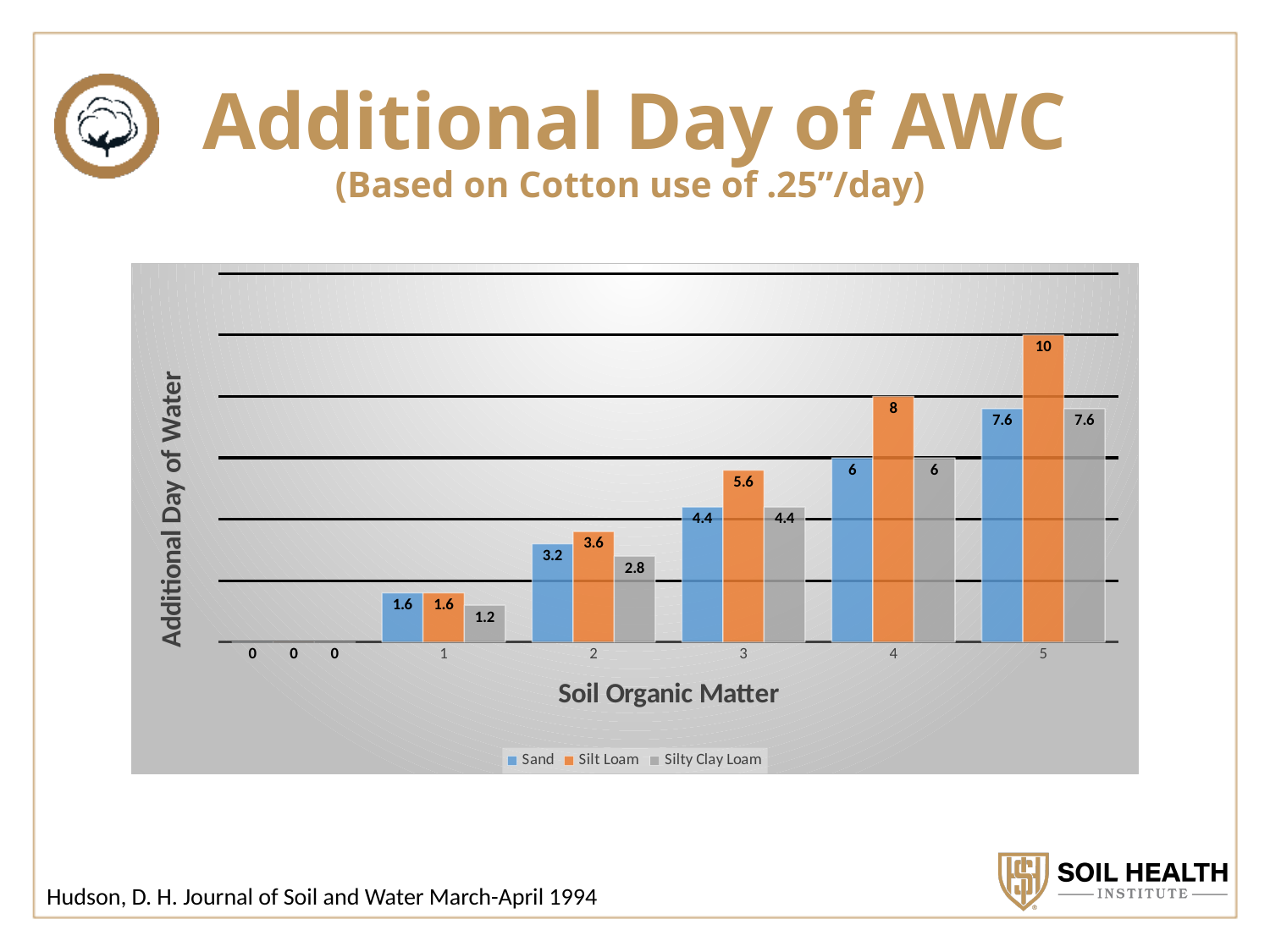
What kind of chart is shown on the slide? bar chart Which is larger: Silt Loam at Soil Organic Matter 3 or Sand at Soil Organic Matter 4? Sand at Soil Organic Matter 4 What is the value for Silty Clay Loam at Soil Organic Matter 2? 2.8 Which series has the highest value at Soil Organic Matter 4? Silt Loam Do the Silt Loam values rise or fall as Soil Organic Matter increases from 0 to 5? rise What is the difference between the Silt Loam and Sand values at Soil Organic Matter 5? 2.4 How many Soil Organic Matter categories are shown on the x axis? 6 Which series has the lowest value at Soil Organic Matter 1? Silty Clay Loam What is the value for Sand at Soil Organic Matter 3? 4.4 What is the value for Silt Loam at Soil Organic Matter 5? 10 What is the label of the y axis? Additional Day of Water How many series does the legend list? 3